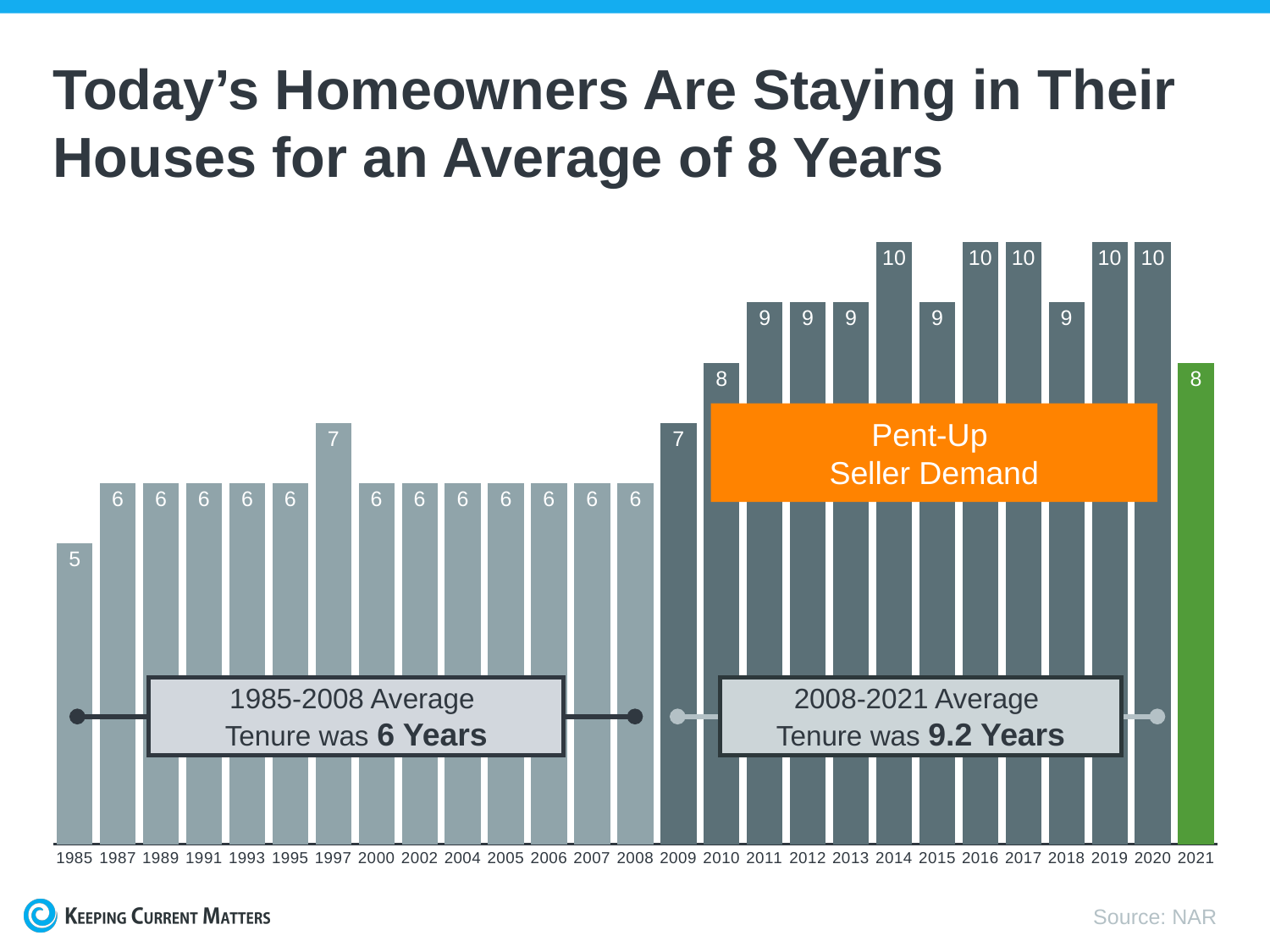
What kind of chart is this? Bar chart What is the highest value shown on the chart? 10 Which year has the lowest value? 1985 What is the value for 1985? 5 How many years are shown on the x axis? 27 Which is larger, the value for 2018 or the value for 2019? 2019 Do the values generally rise or fall from 2008 to 2014? Rise What is the value for 1997? 7 What is the value for 2021? 8 What does the orange box on the chart say? Pent-Up Seller Demand What is the value for 2010? 8 What is the difference between the values for 2014 and 2009? 3